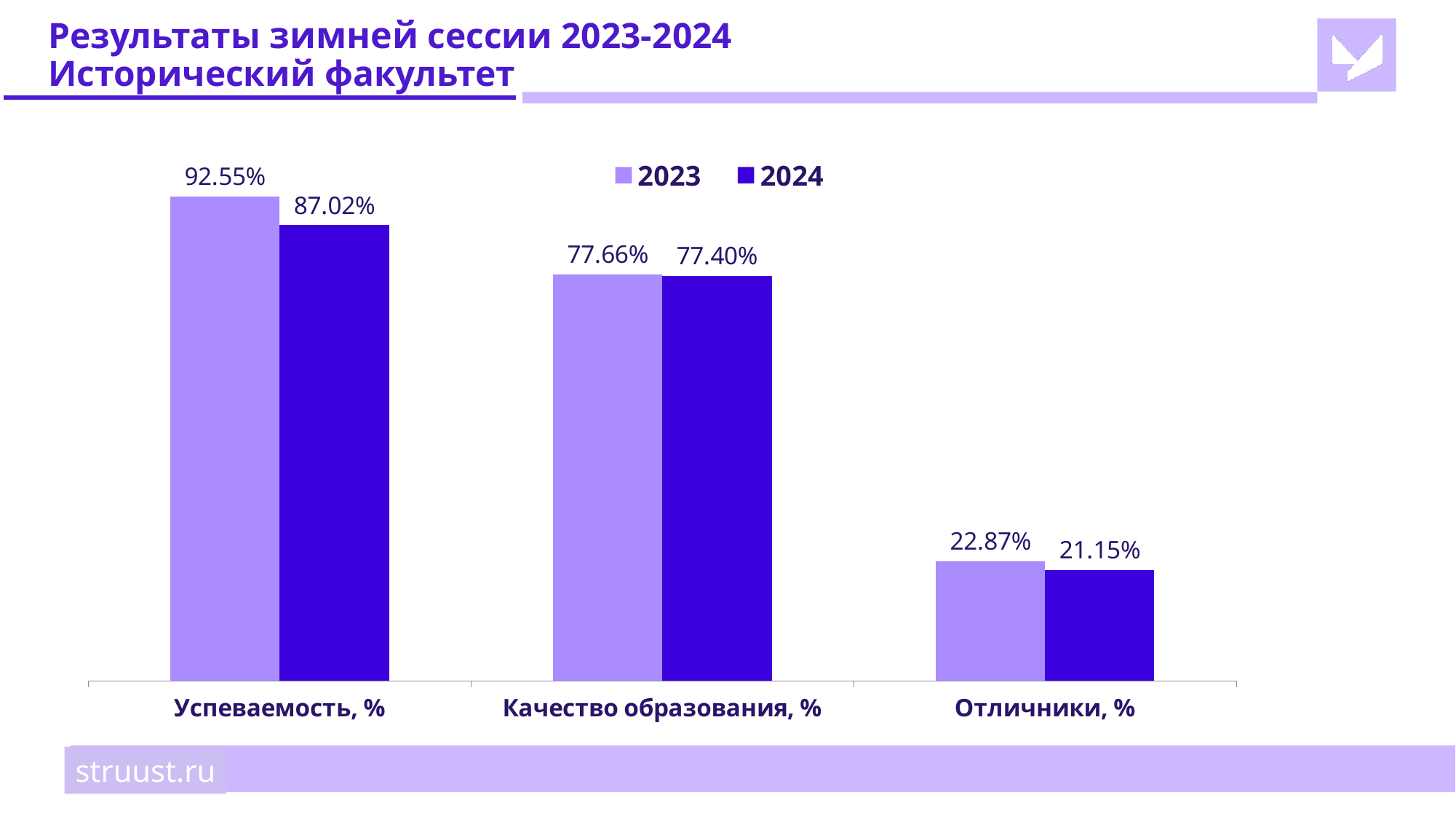
Which series is shown in dark purple according to the legend? 2024 What kind of chart is shown on the slide? Bar chart What is the 2024 value for Отличники, %? 21.15% Which category has the highest 2024 value? Успеваемость, % Which category has the lowest 2023 value? Отличники, % What is the 2023 value for Отличники, %? 22.87% How many series does the legend list? 2 What is the 2023 value for Успеваемость, %? 92.55% Which is larger for Отличники, %: the 2023 value or the 2024 value? 2023 How many categories are shown on the x axis? 3 What is the difference between the 2023 and 2024 values for Успеваемость, %? 5.53% What is the 2024 value for Качество образования, %? 77.40%